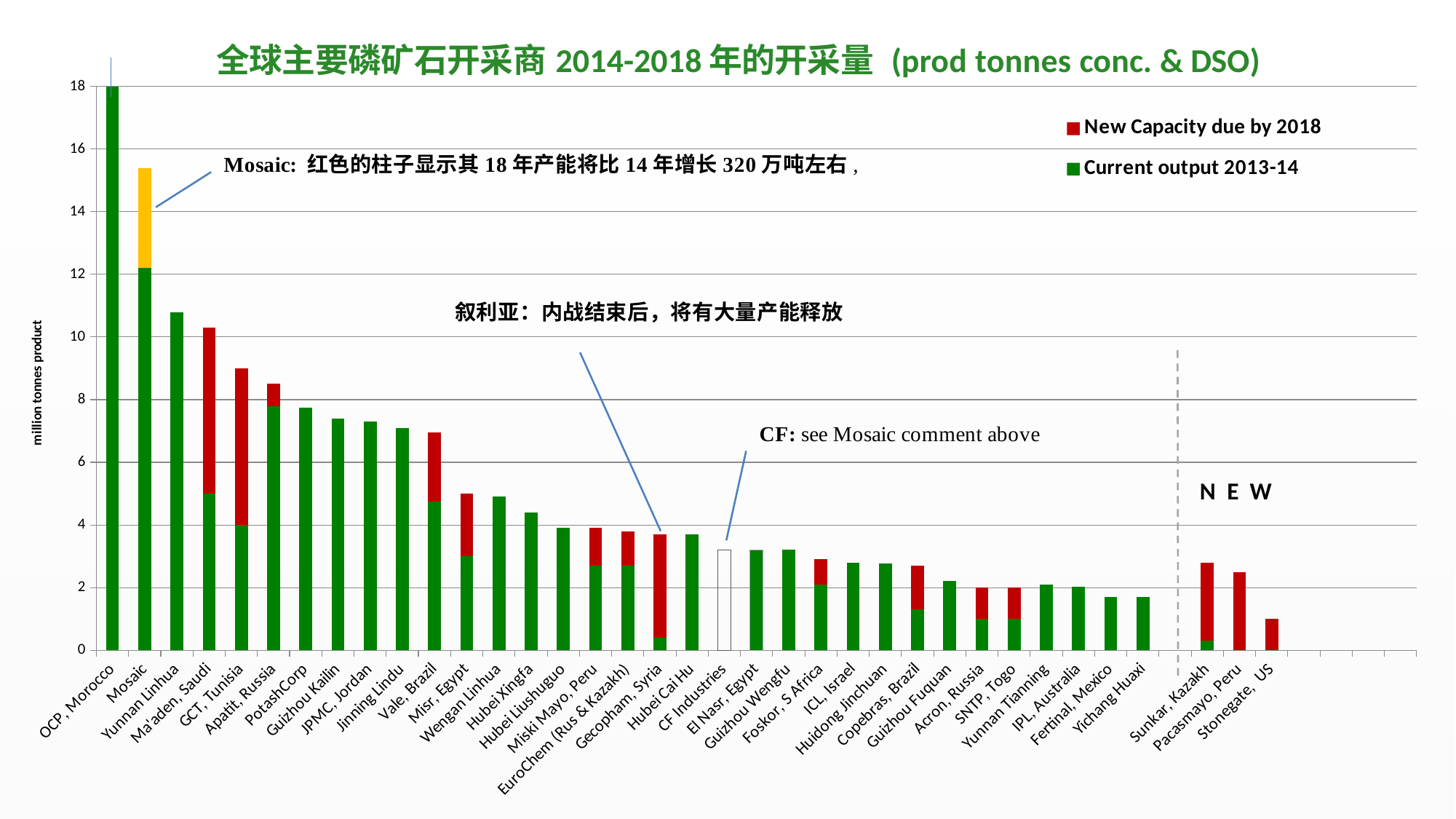
What colour does the legend use for 'New Capacity due by 2018'? Red How many series does the legend list? 2 Is the total value for Yunnan Linhua greater or less than 10? greater How many producers are shown to the right of the dashed 'NEW' line? 3 Is the total value for Mosaic greater or less than 14? greater Which has the larger total bar, Vale, Brazil or Misr, Egypt? Vale, Brazil Is the total value for PotashCorp greater or less than 8? less Which producer has the lowest total bar? Stonegate, US Which producer has the highest total bar? OCP, Morocco What kind of chart is shown on the slide? Stacked bar chart Do the total bar heights generally rise or fall from left to right up to the dashed line? fall